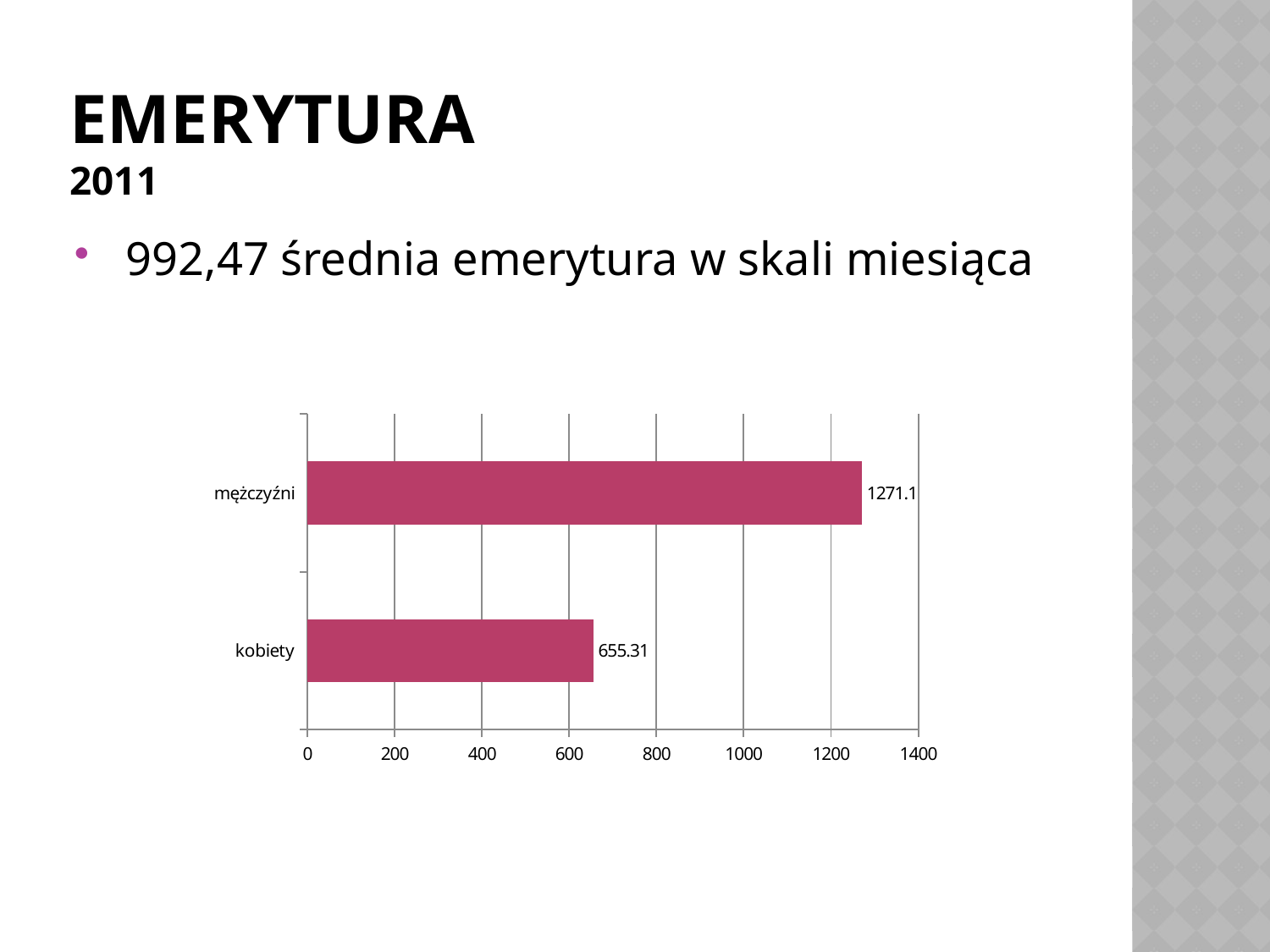
What is the value for kobiety? 655.31 What is the value for mężczyźni? 1271.1 Which category has the highest value? mężczyźni Is the value for mężczyźni greater or less than 1200? greater Is the value for kobiety greater or less than 800? less Which category has the lowest value? kobiety Which is larger, the value for mężczyźni or the value for kobiety? mężczyźni What is the difference between the values for mężczyźni and kobiety? 615.79 How many categories are shown in the chart? 2 What colour are the bars in the chart? magenta/pink What is the maximum value shown on the horizontal axis? 1400 What kind of chart is shown on the slide? bar chart